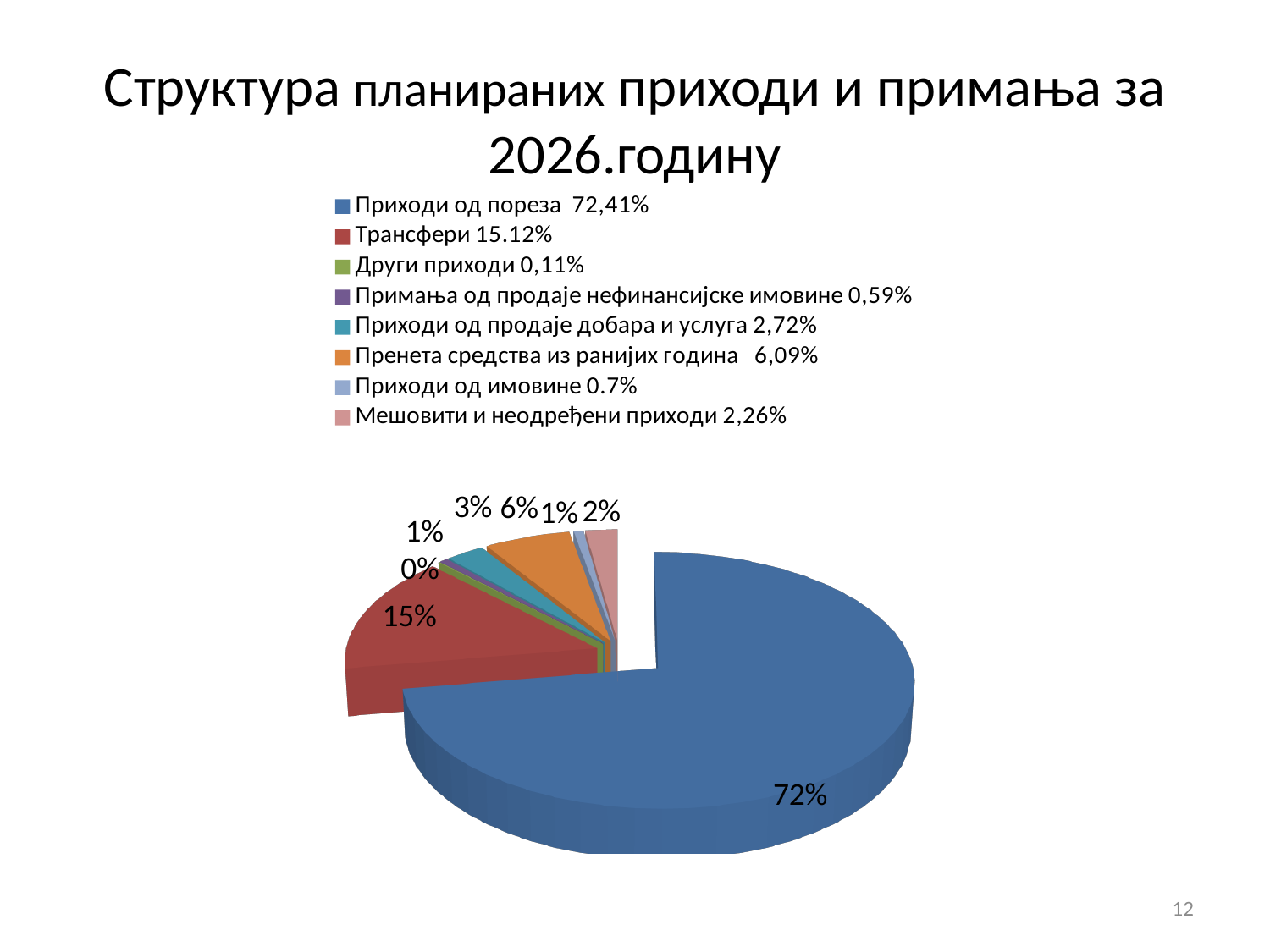
What percentage label is shown on the slice for Трансфери? 15% How many entries does the legend list? 8 Which is larger, the slice for Трансфери or the slice for Пренета средства из ранијих година? Трансфери How many slices does the pie chart have? 8 Which category has the largest slice of the pie? Приходи од пореза What percentage label is shown on the slice for Приходи од продаје добара и услуга? 3% Which category has the smallest slice of the pie? Други приходи By how many percentage points does the Приходи од пореза slice label exceed the Трансфери slice label? 57% What year does the chart title say the planned revenue structure is for? 2026 What percentage label is shown on the slice for Приходи од пореза? 72% What kind of chart is shown on the slide? pie chart What percentage label is shown on the slice for Пренета средства из ранијих година? 6%